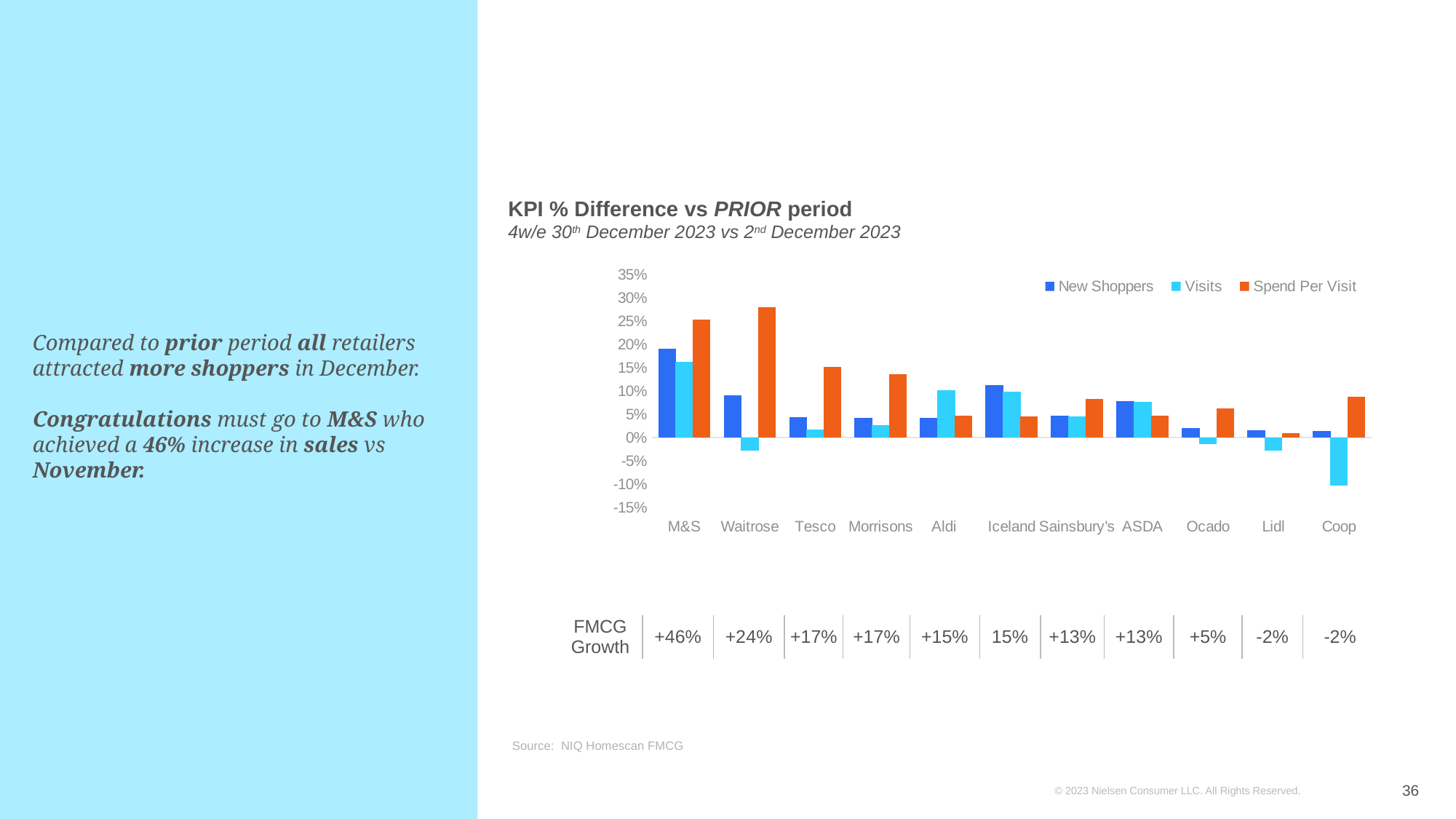
Is the New Shoppers value for M&S greater or less than 15%? greater Is the Spend Per Visit value for Waitrose greater or less than 25%? greater How many series does the legend of the KPI % Difference chart list? 3 Which retailer has the highest Spend Per Visit value in the chart? Waitrose What colour represents the Spend Per Visit series in the chart? orange What kind of chart is shown on the slide? bar chart Which retailer has the lowest Visits value in the chart? Coop Is the Visits value for Coop greater or less than -5%? less Which retailer has the highest New Shoppers value in the chart? M&S How many retailers are shown on the x axis of the chart? 11 For Aldi, which is larger: the Visits value or the New Shoppers value? Visits For Tesco, which is larger: the Spend Per Visit value or the New Shoppers value? Spend Per Visit